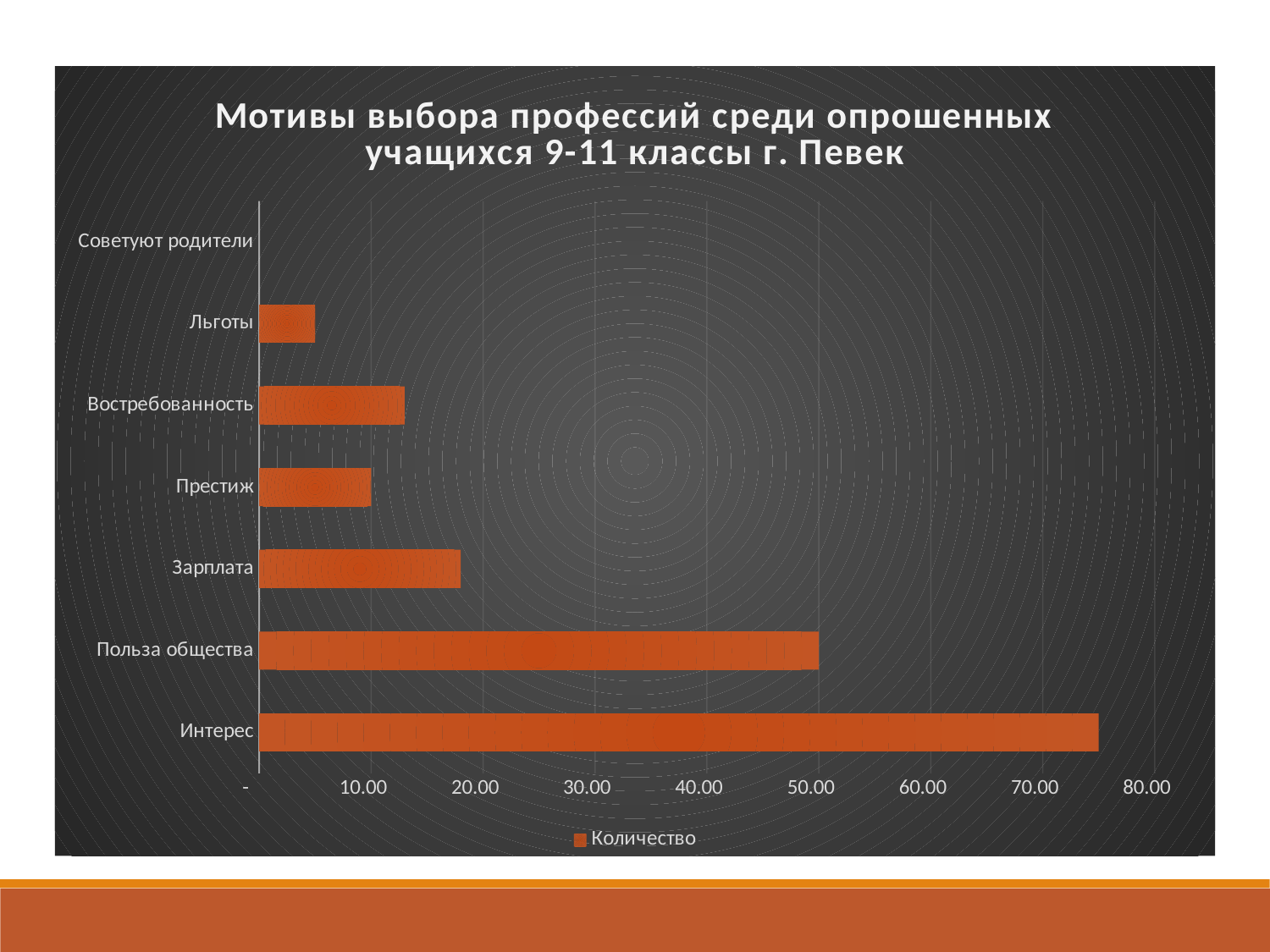
Which is larger, the value for Востребованность or the value for Льготы? Востребованность What is the name of the series shown in the legend? Количество How many series does the legend list? 1 Is the value for Интерес greater or less than 70.00? greater Which category has the lowest value? Советуют родители Is the value for Льготы greater or less than 10.00? less Is the value for Зарплата greater or less than 20.00? less What is the title of the chart? Мотивы выбора профессий среди опрошенных учащихся 9-11 классы г. Певек Which category has the highest value? Интерес What kind of chart is shown on the slide? Bar chart Which is larger, the value for Польза общества or the value for Зарплата? Польза общества How many categories are plotted on the chart? 7